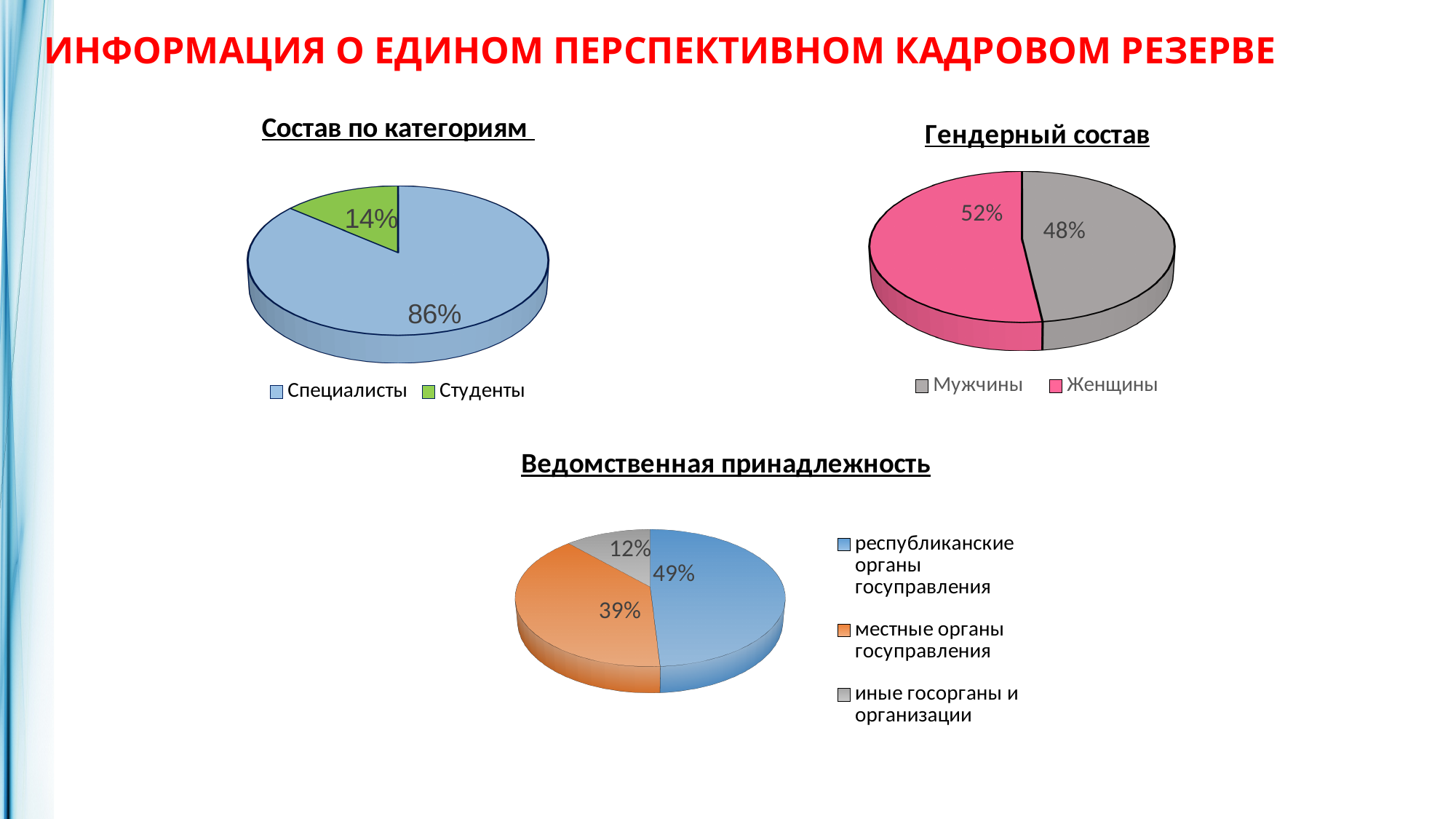
In the 'Гендерный состав' chart, what share is shown for Женщины? 52% In the 'Гендерный состав' chart, what share is shown for Мужчины? 48% In the 'Состав по категориям' chart, what share is shown for Студенты? 14% In the 'Ведомственная принадлежность' chart, which category has the smallest share? иные госорганы и организации What kind of chart is the 'Состав по категориям' chart? Pie chart In the 'Ведомственная принадлежность' chart, what share is shown for местные органы госуправления? 39% In the 'Гендерный состав' chart, what colour is the Женщины slice? Pink How many categories does the legend of the 'Ведомственная принадлежность' chart list? 3 In the 'Ведомственная принадлежность' chart, what is the difference between the shares for республиканские органы госуправления and иные госорганы и организации? 37% In the 'Гендерный состав' chart, what is the difference between the shares for Женщины and Мужчины? 4% In the 'Состав по категориям' chart, what share is shown for Специалисты? 86% In the 'Ведомственная принадлежность' chart, which category has the largest share? республиканские органы госуправления